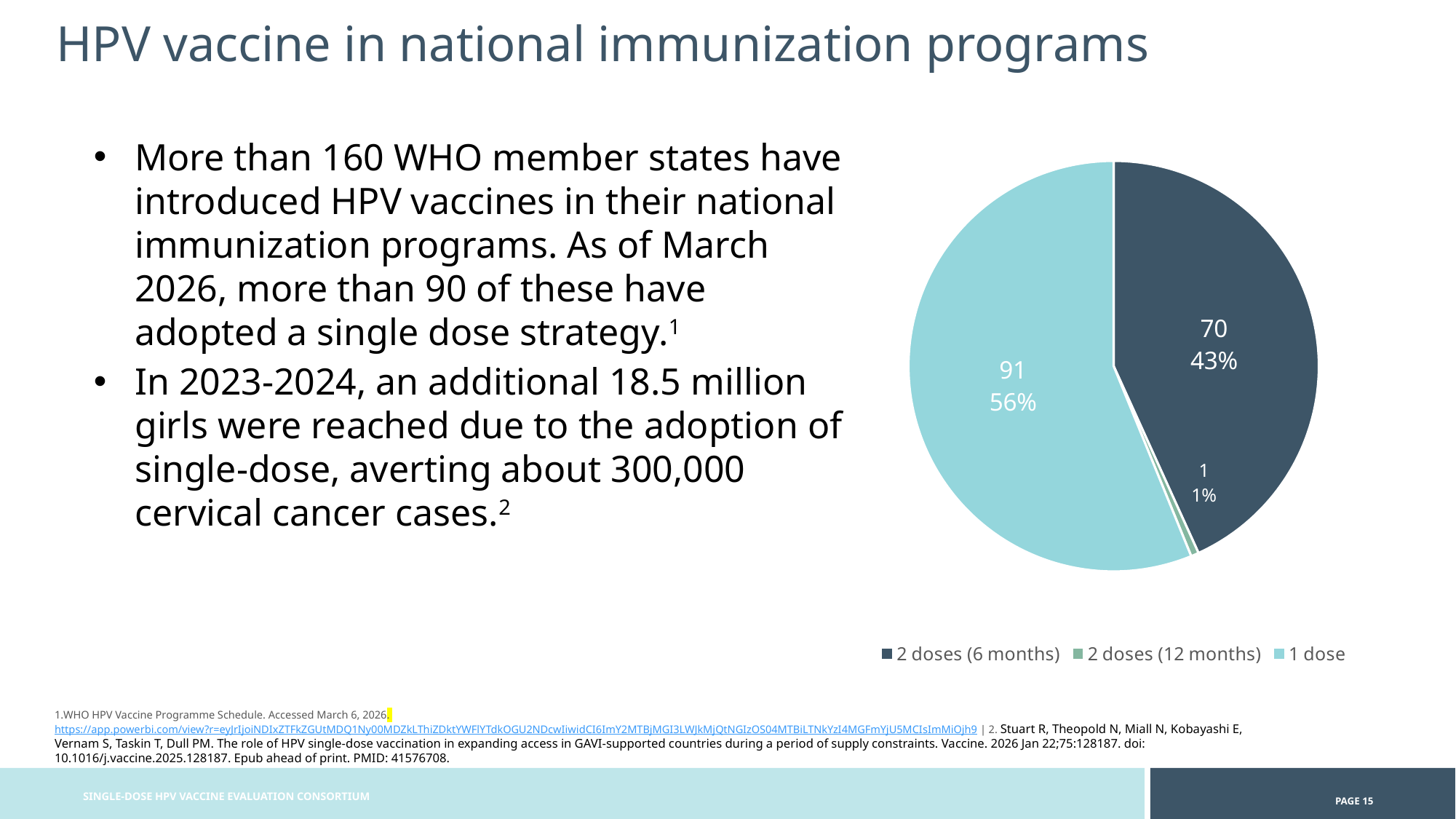
What share of the pie does the 1 dose slice represent? 56% How many entries does the legend of the pie chart list? 3 Which legend entry is shown in dark blue-grey? 2 doses (6 months) How many slices does the pie chart have? 3 What is the difference between the 1 dose value and the 2 doses (6 months) value? 21 Which slice of the pie chart is the largest? 1 dose What is the value shown for the 1 dose slice? 91 Which slice of the pie chart is the smallest? 2 doses (12 months) What share of the pie does the 2 doses (6 months) slice represent? 43% What is the value shown for the 2 doses (6 months) slice? 70 What kind of chart is shown on the slide? pie chart What is the value shown for the 2 doses (12 months) slice? 1